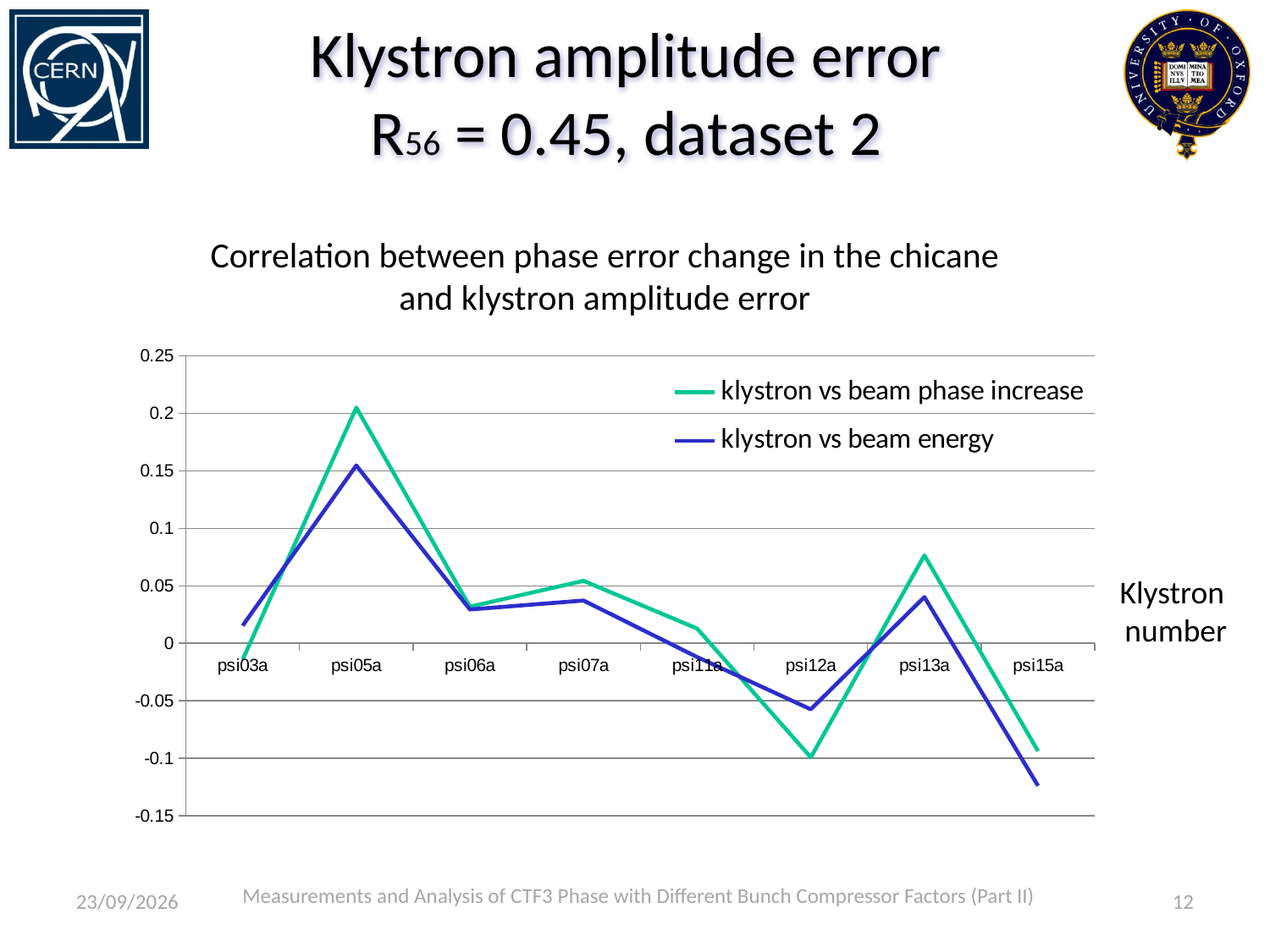
For which klystron is the 'klystron vs beam energy' value lowest? psi15a How many series does the chart legend list? 2 Is the 'klystron vs beam phase increase' value for psi12a greater or less than -0.05? less For which klystron is the 'klystron vs beam phase increase' value highest? psi05a At psi05a, which series has the larger value: 'klystron vs beam phase increase' or 'klystron vs beam energy'? klystron vs beam phase increase What label is given to the x axis of the chart? Klystron number How many klystron categories are plotted along the x axis? 8 Is the 'klystron vs beam energy' value for psi15a greater or less than -0.1? less Is the 'klystron vs beam phase increase' value for psi05a greater or less than 0.15? greater At psi15a, which series has the lower value: 'klystron vs beam phase increase' or 'klystron vs beam energy'? klystron vs beam energy What kind of chart is shown on the slide? line chart For which klystron is the 'klystron vs beam energy' value highest? psi05a